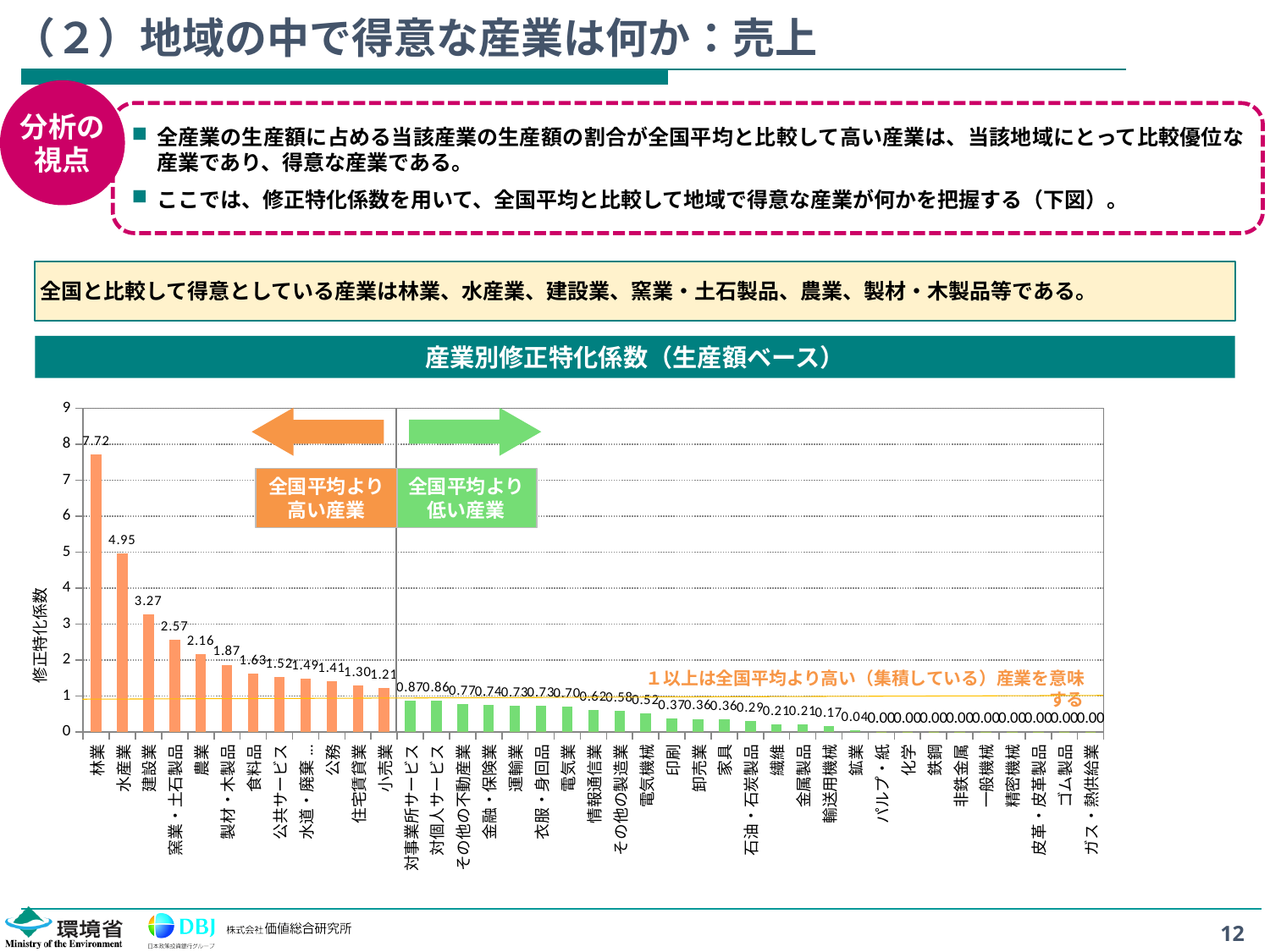
Which industry has the highest 修正特化係数 in the chart? 林業 Is the 修正特化係数 value for 水産業 greater or less than 4? greater What type of chart is shown under the title 産業別修正特化係数（生産額ベース）? bar chart What is the 修正特化係数 value for 農業? 2.16 What is the 修正特化係数 value for 水産業? 4.95 How many industries are shown with orange bars (全国平均より高い産業)? 12 What is the 修正特化係数 value for 建設業? 3.27 What is the 修正特化係数 value for 林業? 7.72 Which has a larger 修正特化係数, 建設業 or 農業? 建設業 What is the 修正特化係数 value for 小売業? 1.21 Do the bar values rise or fall from left to right along the x axis? fall What is the difference between the 修正特化係数 values for 林業 and 水産業? 2.77